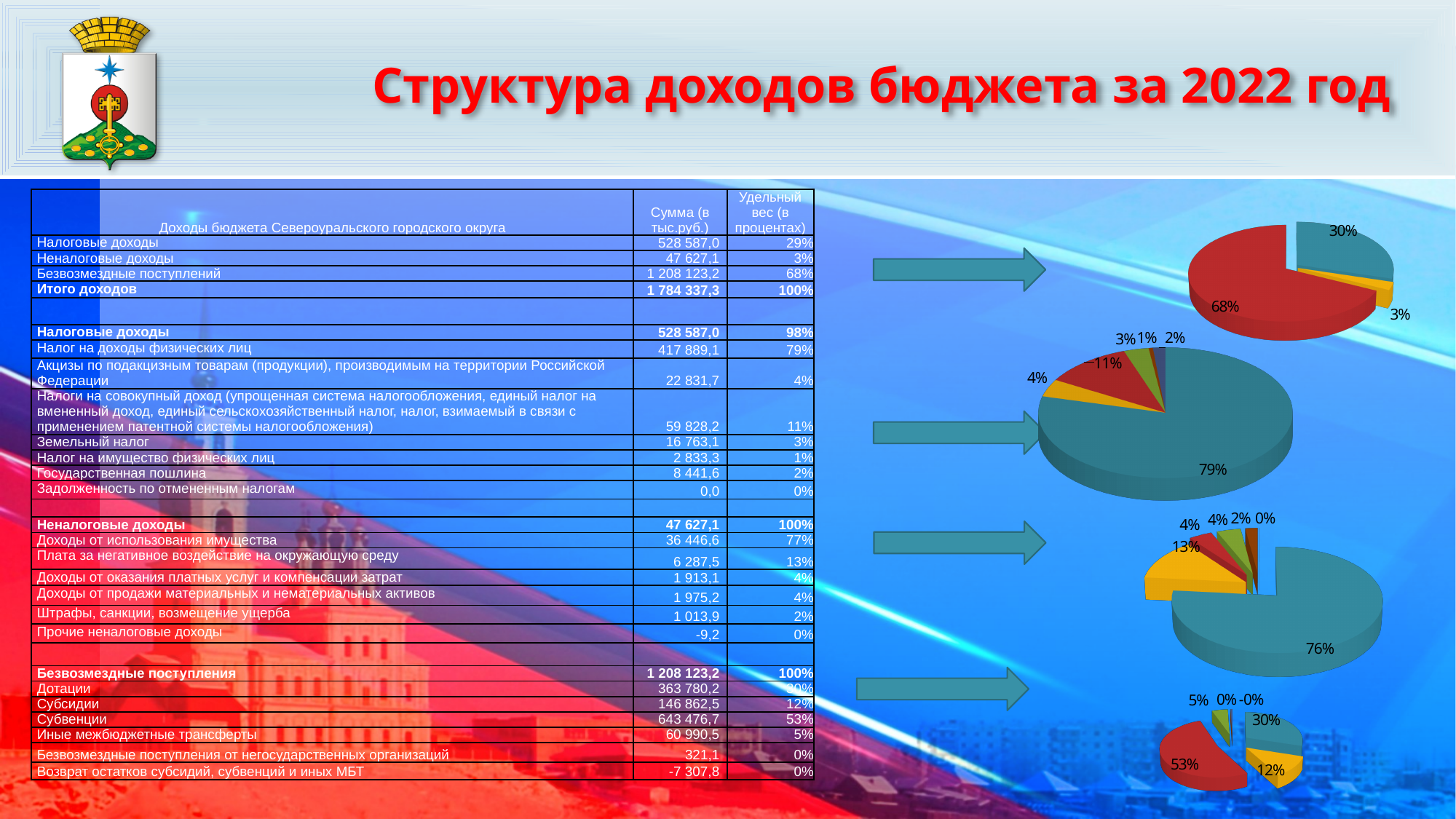
In the third pie chart from the top on the right, what is the share of the largest slice? 76% In the bottom pie chart on the right, what is the share of the largest slice? 53% What kind of chart is the top chart on the right side of the slide? Pie chart How many slices are labelled in the top pie chart on the right? 3 In the third pie chart from the top on the right, what is the share of the yellow slice? 13% In the second pie chart from the top on the right, what is the share of the largest slice? 79% How many pie charts are shown on the right side of the slide? 4 In the top pie chart on the right, what is the share of the blue slice? 30% In the bottom pie chart on the right, which slice is larger: the one labelled 30% or the one labelled 12%? 30% In the top pie chart on the right, what is the share of the smallest slice? 3% In the second pie chart from the top on the right, what is the share of the red slice? 11%